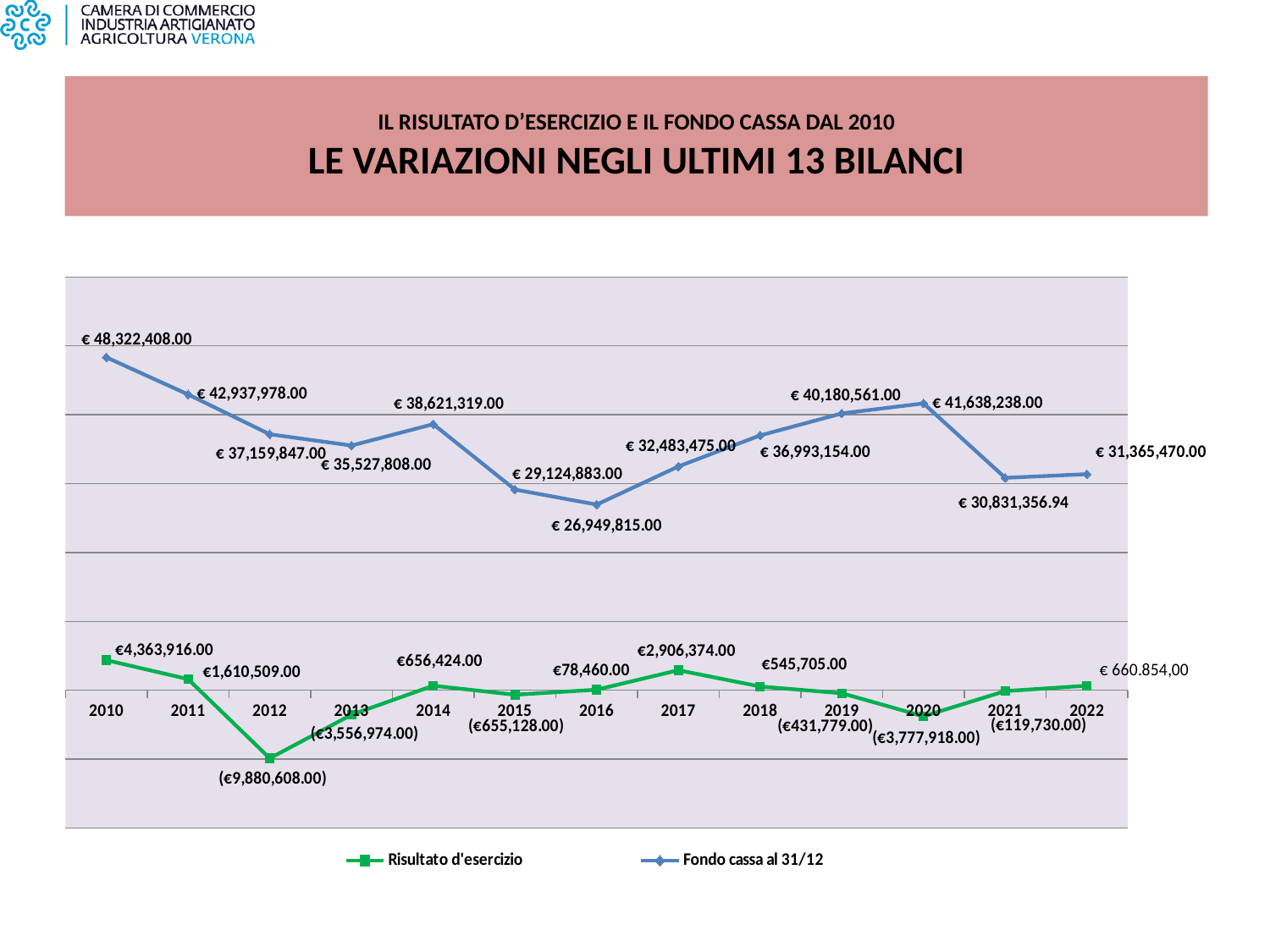
What is the value of Fondo cassa al 31/12 for 2021? € 30,831,356.94 In which year is Fondo cassa al 31/12 highest? 2010 In which year is Fondo cassa al 31/12 lowest? 2016 What is the value of Risultato d'esercizio for 2017? €2,906,374.00 How many years are plotted along the x axis? 13 What kind of chart is shown on the slide? Line chart What is the value of Fondo cassa al 31/12 for 2010? € 48,322,408.00 Does Fondo cassa al 31/12 rise or fall from 2010 to 2013? Fall Which is larger, Fondo cassa al 31/12 in 2019 or in 2018? 2019 In which year is Risultato d'esercizio lowest? 2012 How many series does the legend list? 2 What is the difference between Fondo cassa al 31/12 in 2010 and in 2011? € 5,384,430.00